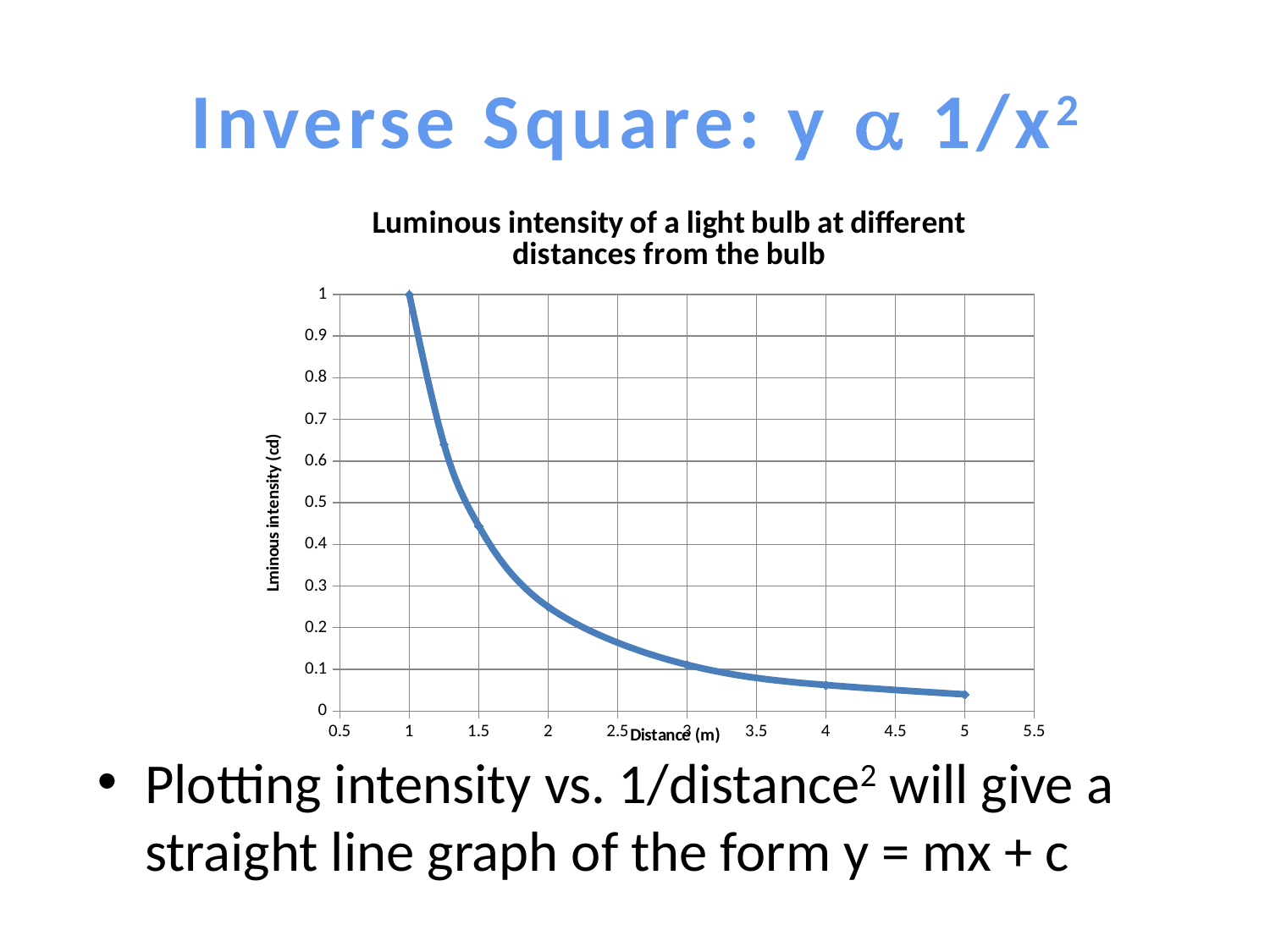
At which plotted distance is the luminous intensity lowest? 5 What is the luminous intensity at a distance of 1 m? 1 What kind of chart is shown on the slide? line chart What is the label of the y axis? Lminous intensity (cd) What is the title of the chart? Luminous intensity of a light bulb at different distances from the bulb Is the luminous intensity at a distance of 5 m greater or less than 0.1? less Is the luminous intensity at a distance of 1.5 m greater or less than 0.5? less At which distance is the luminous intensity highest? 1 Which is larger, the luminous intensity at 2 m or at 4 m? 2 m Is the luminous intensity at a distance of 2 m greater or less than 0.3? less Does the luminous intensity rise or fall as distance increases? fall